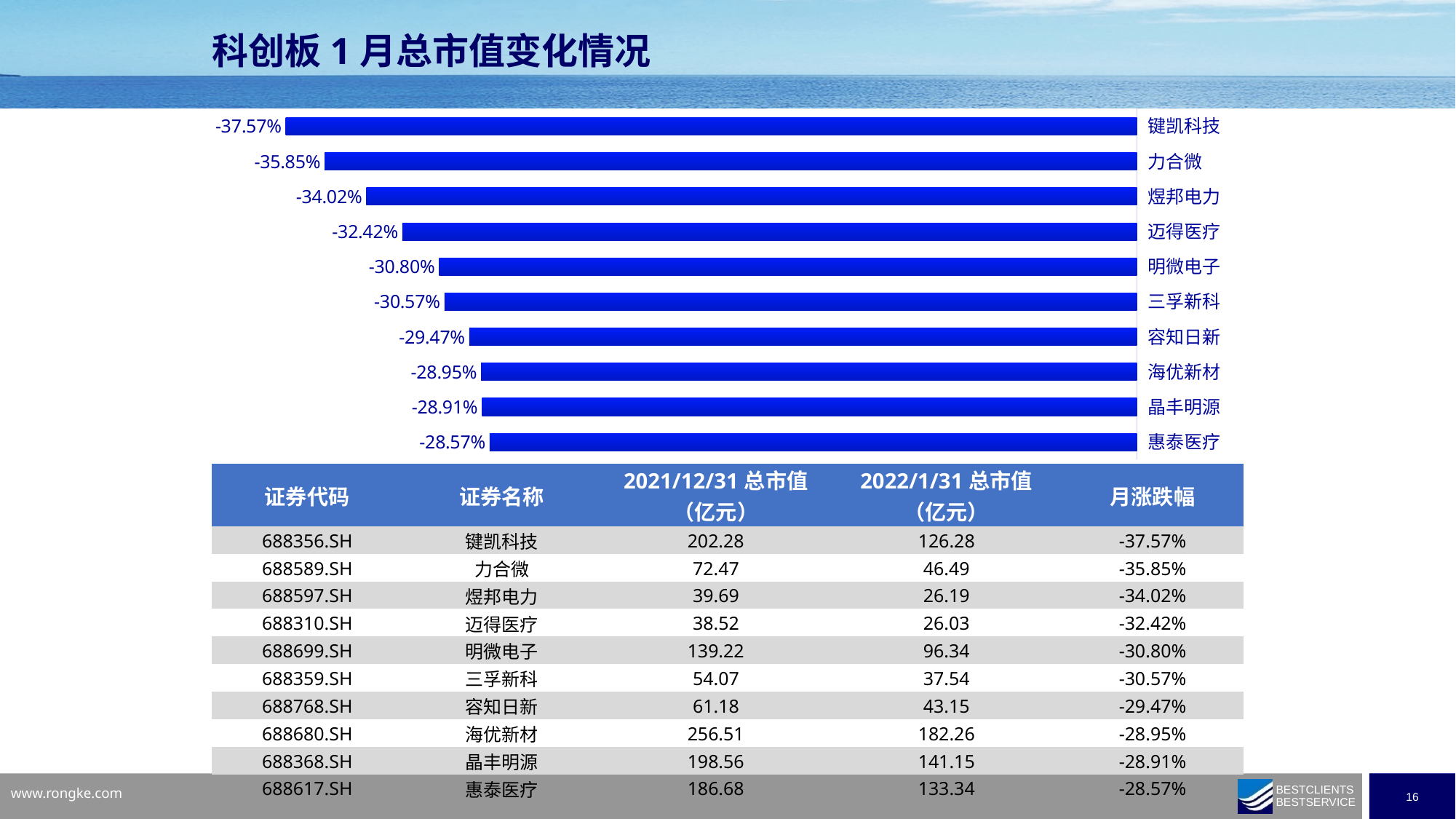
What is the title of the slide containing the bar chart? 科创板 1 月总市值变化情况 What is the monthly change shown for 惠泰医疗 in the bar chart? -28.57% What is the monthly change shown for 键凯科技 in the bar chart? -37.57% Which has the larger (less negative) value, 迈得医疗 or 容知日新? 容知日新 Which company has the smallest decline (highest value) in the bar chart? 惠泰医疗 Which company has the largest decline (lowest value) in the bar chart? 键凯科技 What is the difference in percentage points between the values for 力合微 and 煜邦电力? 1.83 What type of chart is shown on the slide? bar chart What is the monthly change shown for 容知日新 in the bar chart? -29.47% What is the monthly change shown for 明微电子 in the bar chart? -30.80% How many companies are plotted in the bar chart? 10 What is the difference in percentage points between the values for 键凯科技 and 惠泰医疗? 9.00